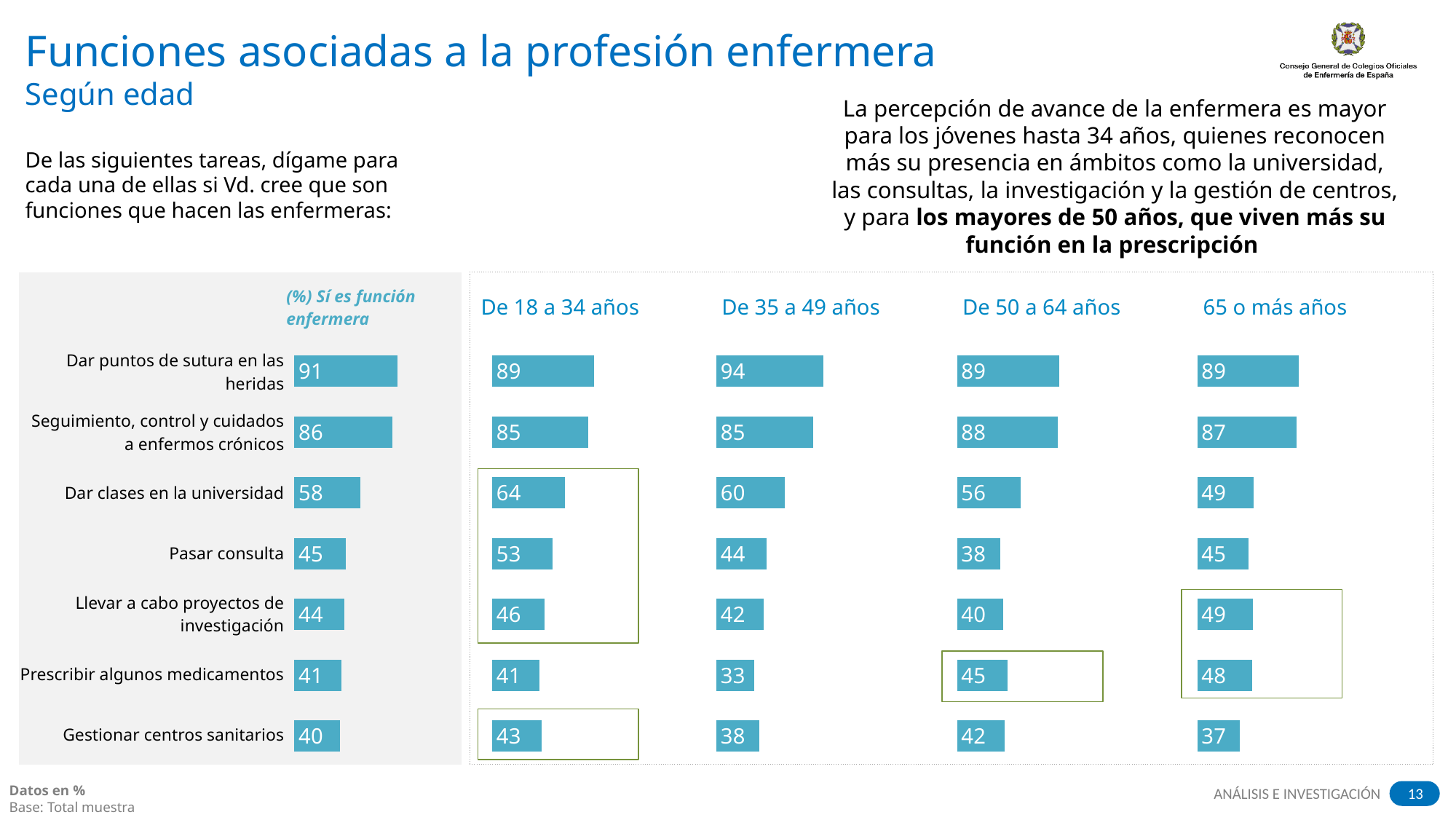
In the "De 50 a 64 años" chart, what is the value for "Llevar a cabo proyectos de investigación"? 40 In the "De 35 a 49 años" chart, which category has the lowest value? Prescribir algunos medicamentos What type of chart is the "De 18 a 34 años" chart? Bar chart In the "De 18 a 34 años" chart, what is the value for "Pasar consulta"? 53 In the "De 35 a 49 años" chart, what is the value for "Prescribir algunos medicamentos"? 33 How many categories are shown in the "(%) Sí es función enfermera" chart? 7 In the "65 o más años" chart, what is the value for "Gestionar centros sanitarios"? 37 In the "(%) Sí es función enfermera" chart, what is the value for "Dar clases en la universidad"? 58 In the "De 35 a 49 años" chart, which category has the highest value? Dar puntos de sutura en las heridas For "Prescribir algunos medicamentos", which chart shows the larger value: "De 50 a 64 años" or "De 18 a 34 años"? De 50 a 64 años In the "De 50 a 64 años" chart, which category has the lowest value? Pasar consulta In the "De 18 a 34 años" chart, what is the difference between "Dar clases en la universidad" and "Gestionar centros sanitarios"? 21